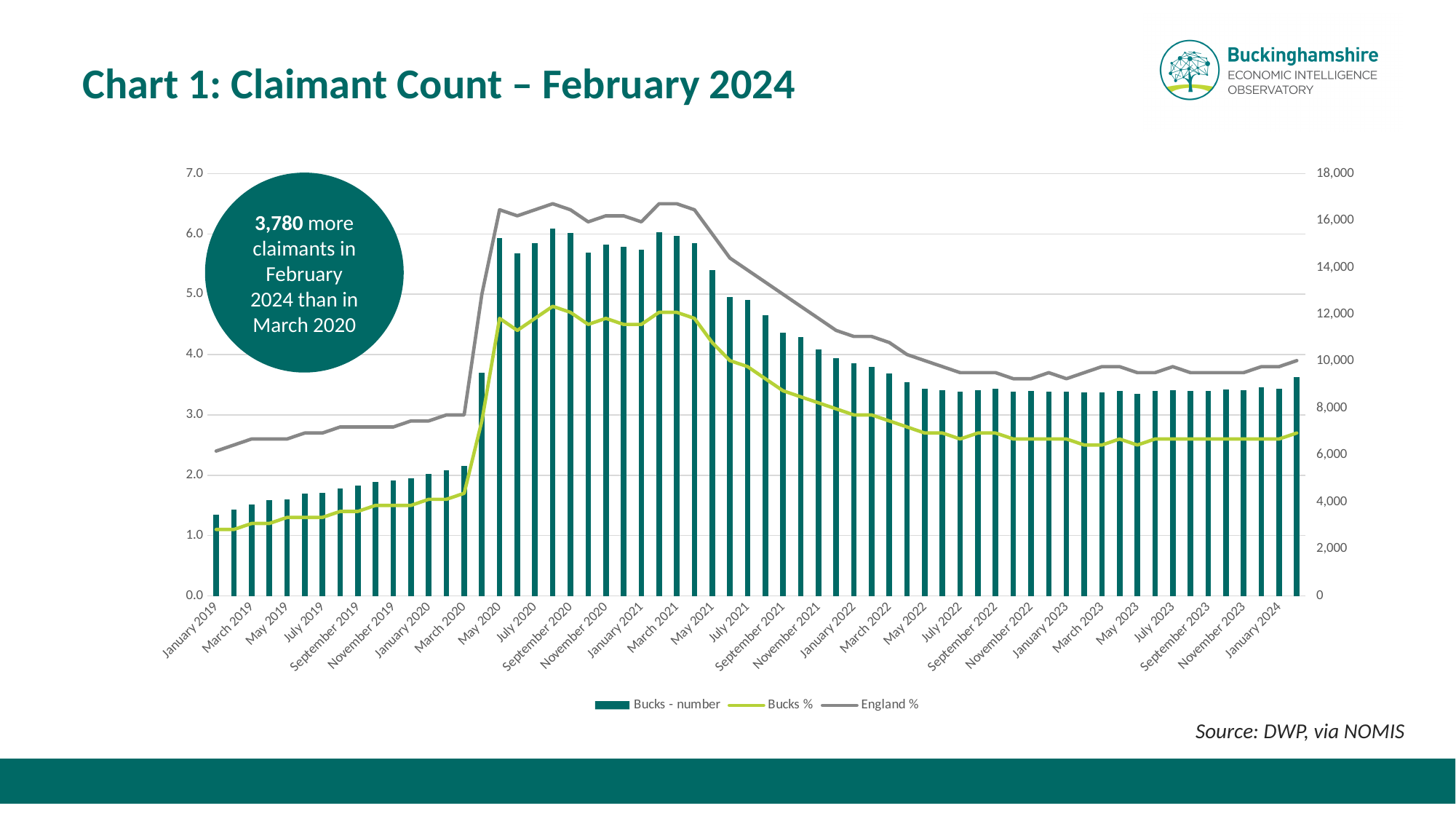
Is the value for Bucks % in March 2020 greater or less than 2.0? less Is the value for Bucks - number in January 2019 greater or less than 4,000? less How many series does the legend list? 3 Do the values for Bucks - number rise or fall from May 2021 to July 2022? fall Is the value for Bucks - number in May 2020 greater or less than 8,000? greater Which month has the lowest value for Bucks - number? January 2019 In May 2020, which is larger, Bucks % or England %? England % What kind of chart is this? Combined bar and line chart According to the callout, how many more claimants were there in February 2024 than in March 2020? 3,780 Which series is plotted as bars? Bucks - number